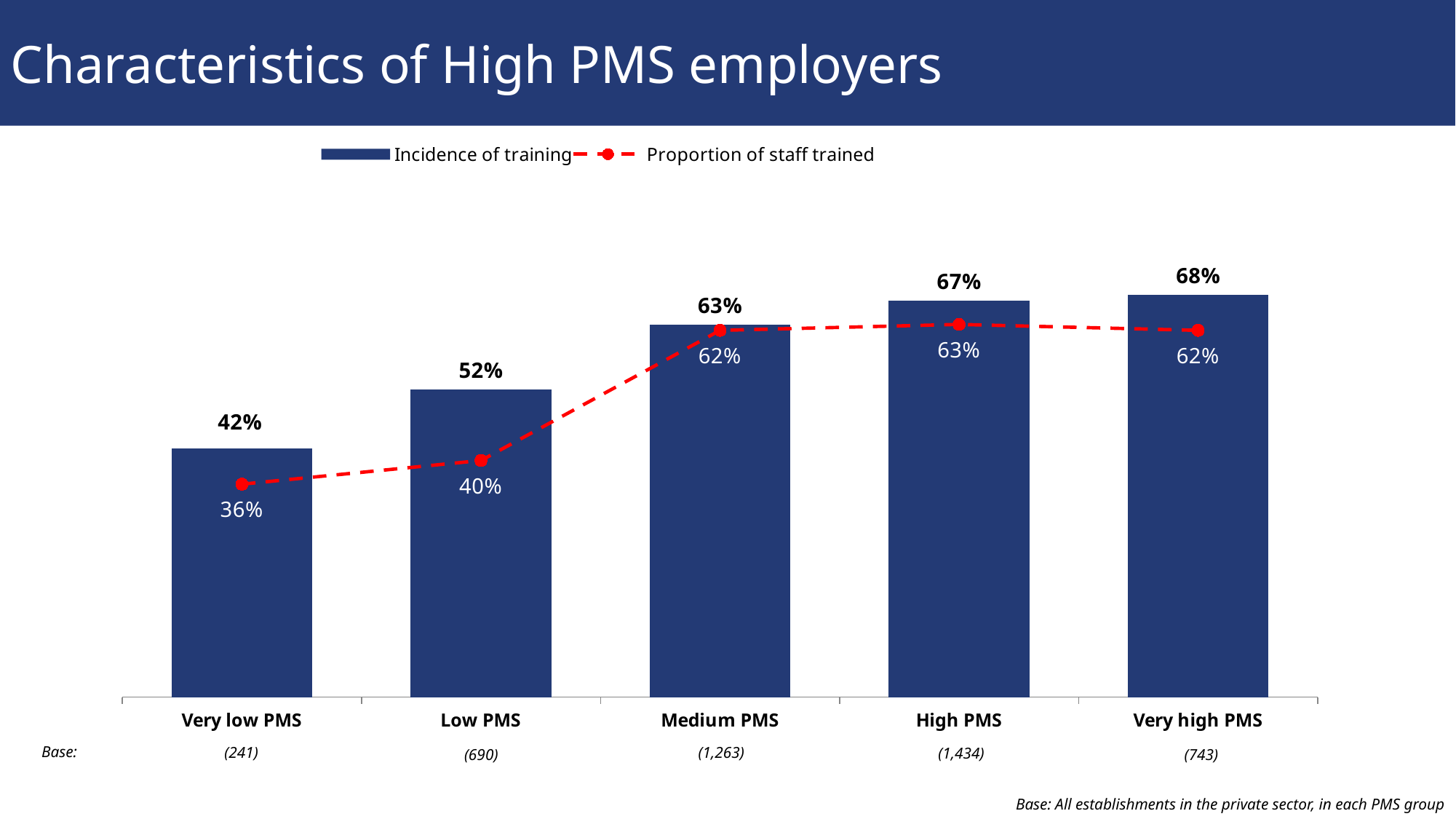
What is the Proportion of staff trained for Low PMS? 40% Does the Incidence of training rise or fall from Very low PMS to Very high PMS? rise What is the Incidence of training for Very low PMS? 42% Which PMS group has the highest Incidence of training? Very high PMS What is the Incidence of training for High PMS? 67% What is the base (number of establishments) for the High PMS group? (1,434) What is the difference in Incidence of training between Medium PMS and Low PMS? 11% Which PMS group has the lowest Proportion of staff trained? Very low PMS Which is larger: the Incidence of training for Low PMS or for Very low PMS? Low PMS What is the Proportion of staff trained for Medium PMS? 62% How many series does the legend list? 2 How many PMS groups are shown on the x axis? 5